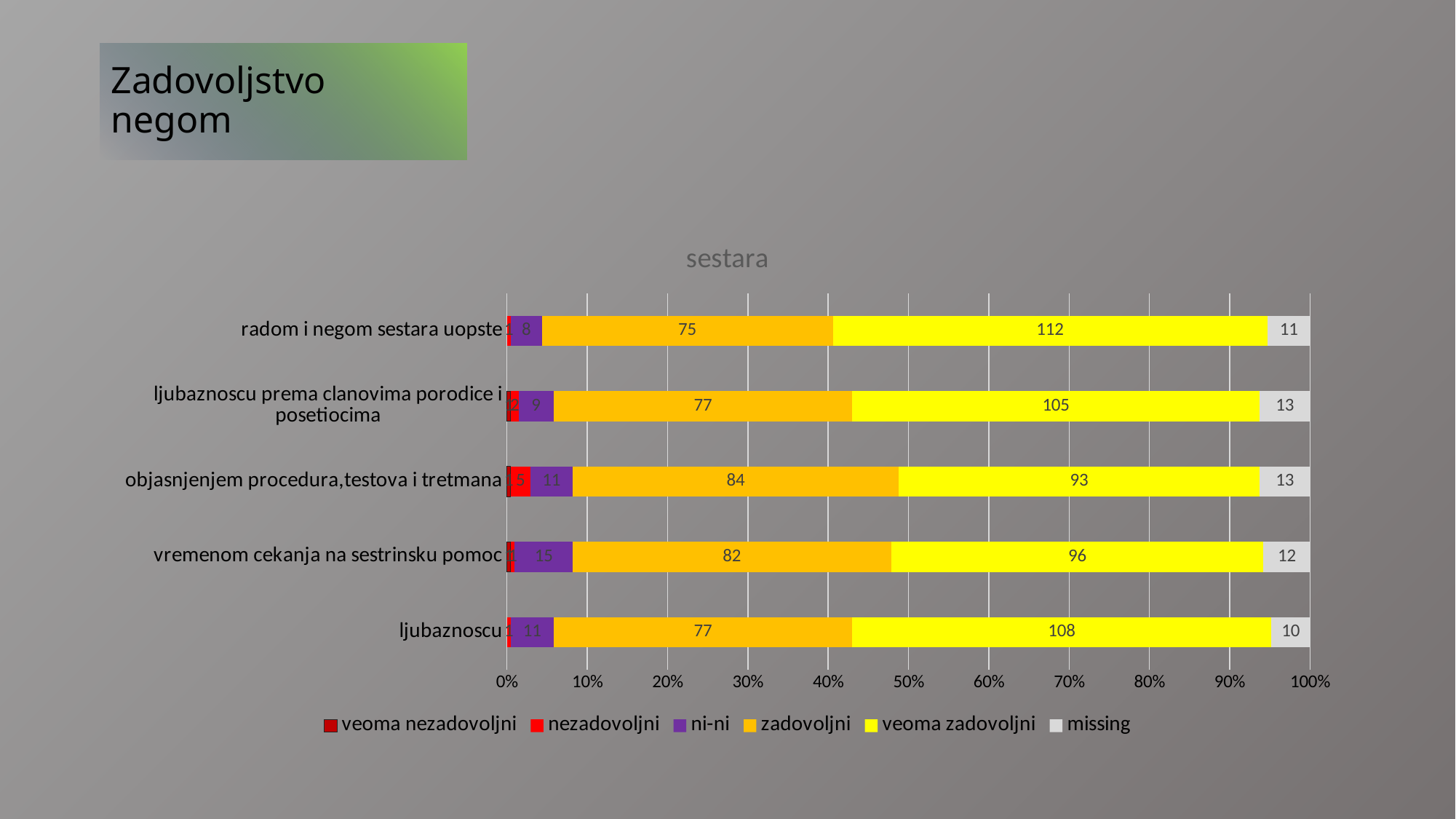
Which has the larger 'ni-ni' value: 'vremenom cekanja na sestrinsku pomoc' or 'ljubaznoscu'? vremenom cekanja na sestrinsku pomoc What kind of chart is shown on the slide? bar chart Which category has the lowest 'veoma zadovoljni' value? objasnjenjem procedura,testova i tretmana How many categories are plotted on the chart? 5 What is the difference between the 'veoma zadovoljni' values for 'radom i negom sestara uopste' and 'objasnjenjem procedura,testova i tretmana'? 19 What is the 'missing' value for 'ljubaznoscu'? 10 What is the 'veoma zadovoljni' value for 'radom i negom sestara uopste'? 112 How many series does the legend list? 6 What is the 'ni-ni' value for 'ljubaznoscu prema clanovima porodice i posetiocima'? 9 What is the title of the chart? sestara Which category has the highest 'veoma zadovoljni' value? radom i negom sestara uopste What is the 'zadovoljni' value for 'objasnjenjem procedura,testova i tretmana'? 84